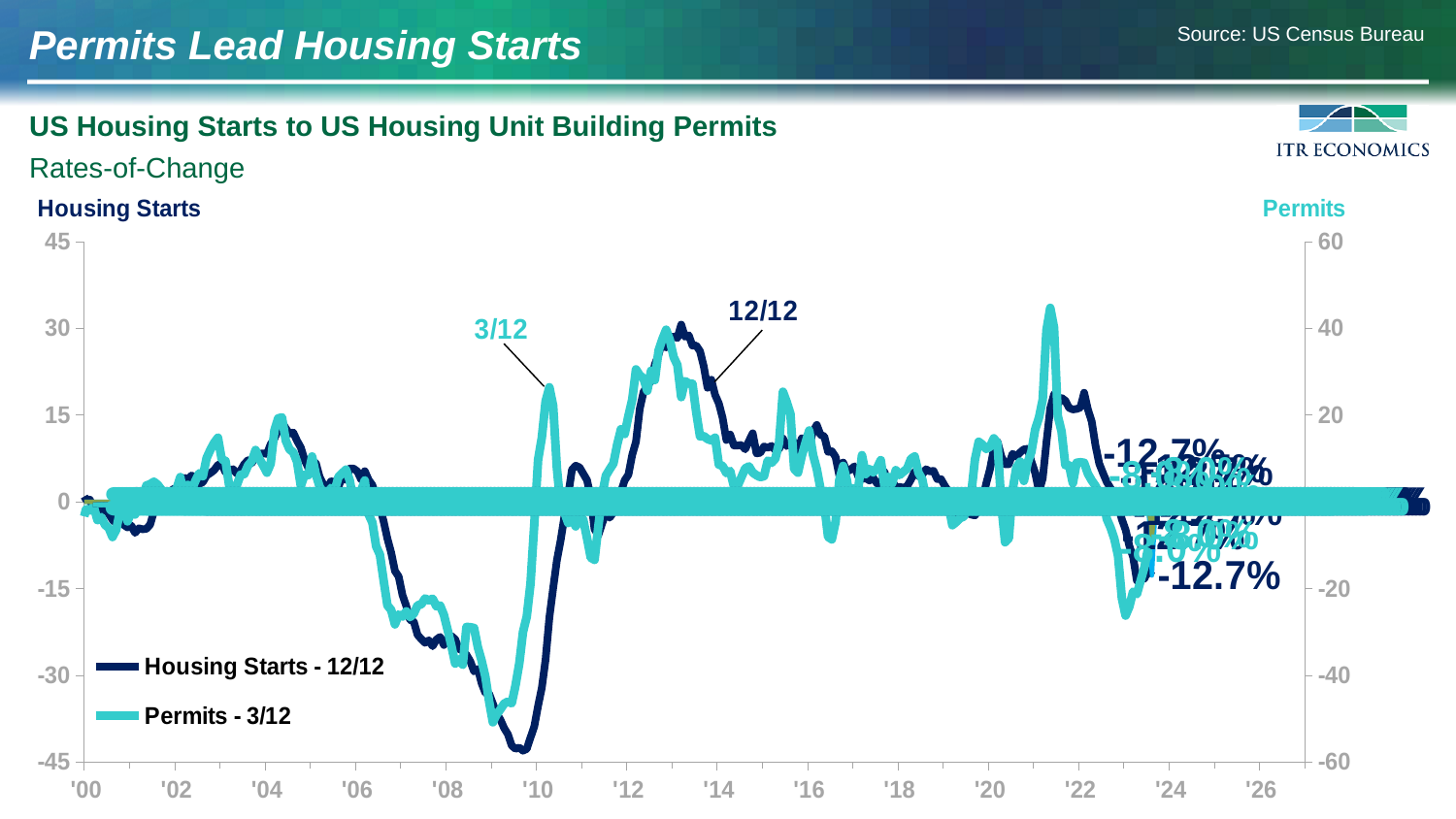
Is the Permits - 3/12 value at its peak around 2021 greater or less than 40 on the right axis? greater Is the Housing Starts - 12/12 value at its lowest point around 2009-2010 greater or less than -30 on the left axis? less Does the Housing Starts - 12/12 line rise or fall between 2006 and 2009? fall Is the Permits - 3/12 value at its low point around 2009 greater or less than -40 on the right axis? less What are the two series named in the legend? Housing Starts - 12/12 and Permits - 3/12 What is the title of the chart? US Housing Starts to US Housing Unit Building Permits What is the maximum value shown on the left (Housing Starts) axis? 45 Does the Housing Starts - 12/12 line rise or fall between 2010 and 2013? rise What kind of chart is shown on the slide? Line chart How many series does the legend list? 2